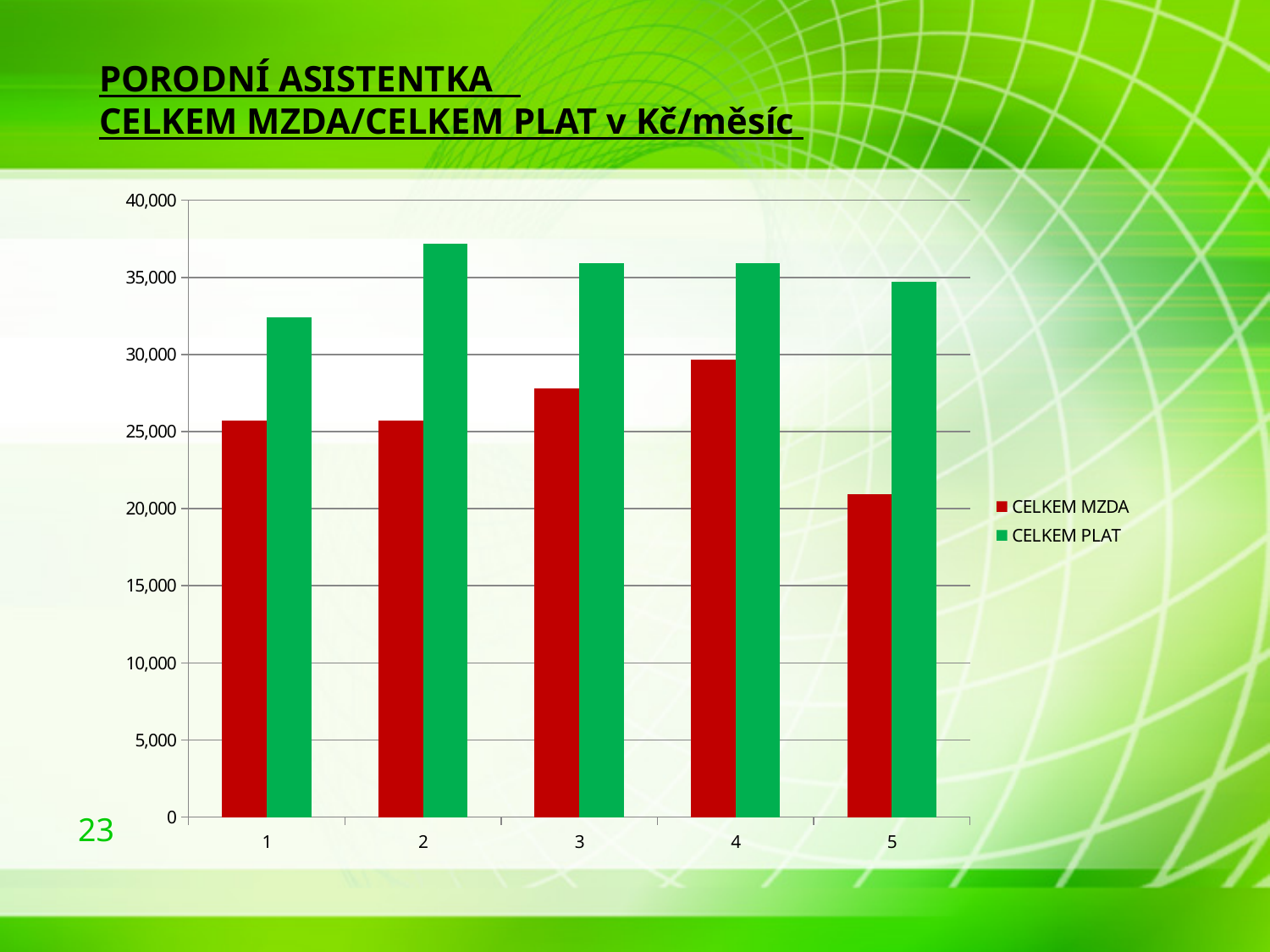
Is the CELKEM PLAT value for category 2 greater or less than 35,000? greater Which category has the lowest CELKEM MZDA value? 5 Which category has the lowest CELKEM PLAT value? 1 Which colour represents CELKEM PLAT in the chart? green In category 1, which is larger: CELKEM MZDA or CELKEM PLAT? CELKEM PLAT What kind of chart is shown on the slide? bar chart Which category has the highest CELKEM MZDA value? 4 Which category has the highest CELKEM PLAT value? 2 How many series does the legend list? 2 How many categories are shown on the x axis? 5 Is the CELKEM MZDA value for category 5 greater or less than 25,000? less